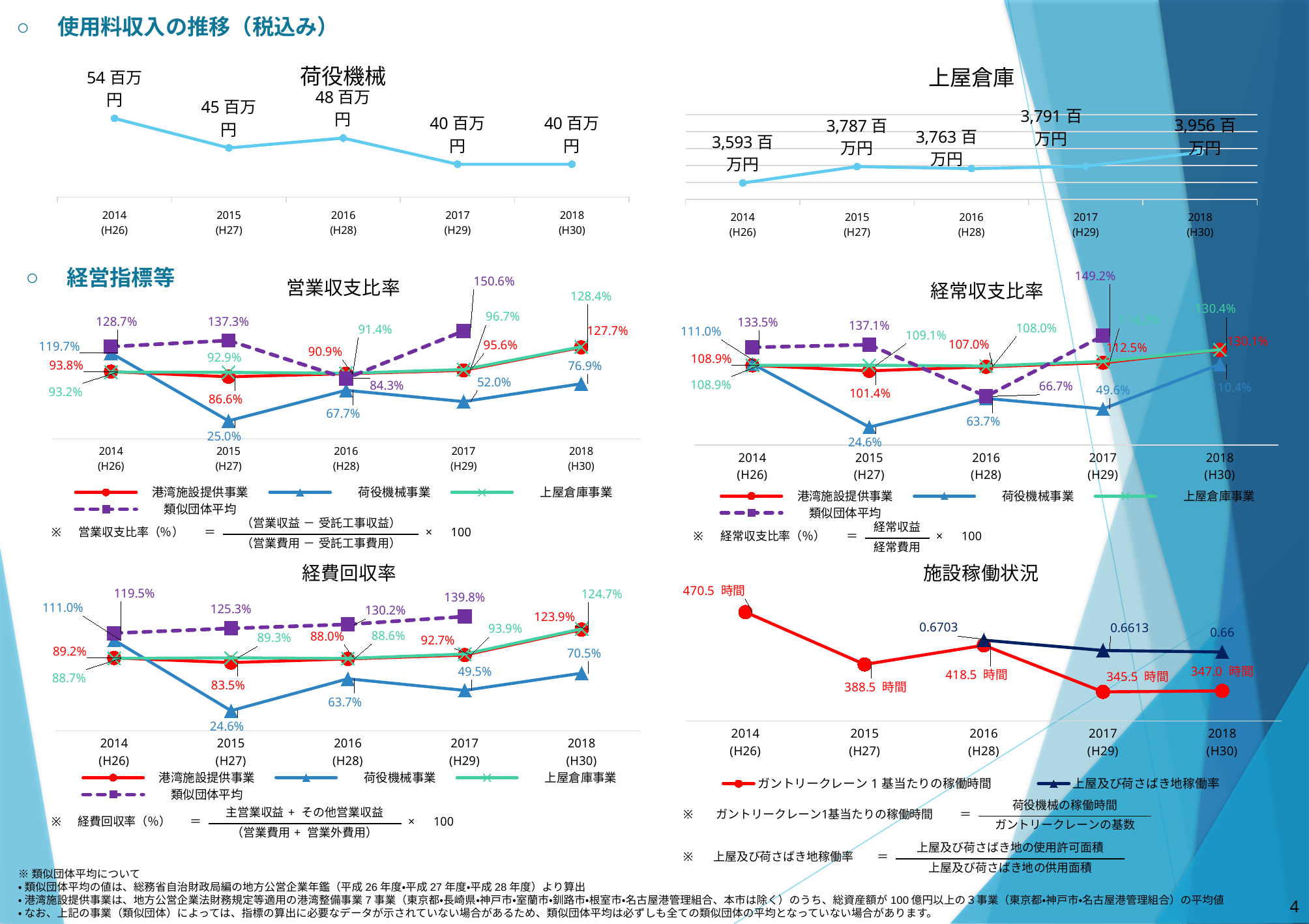
In the 経費回収率 chart, which is larger in 2018 (H30): 港湾施設提供事業 or 荷役機械事業? 港湾施設提供事業 In the 営業収支比率 chart, how many series does the legend list? 4 In the 経常収支比率 chart, what is the value for 類似団体平均 in 2017 (H29)? 149.2% In the 荷役機械 chart, which year has the highest value? 2014 (H26) In the 経費回収率 chart, what is the value for 上屋倉庫事業 in 2018 (H30)? 124.7% In the 施設稼働状況 chart, what is the value for ガントリークレーン 1 基当たりの稼働時間 in 2014 (H26)? 470.5 時間 In the 荷役機械 chart, what is the value for 2014 (H26)? 54 百万円 In the 営業収支比率 chart, what is the value for 荷役機械事業 in 2015 (H27)? 25.0% In the 上屋倉庫 chart, which year has the lowest value? 2014 (H26) In the 上屋倉庫 chart, what is the difference between the 2018 (H30) and 2014 (H26) values? 363 百万円 In the 上屋倉庫 chart, what is the value for 2018 (H30)? 3,956 百万円 What kind of chart is the 施設稼働状況 chart? line chart